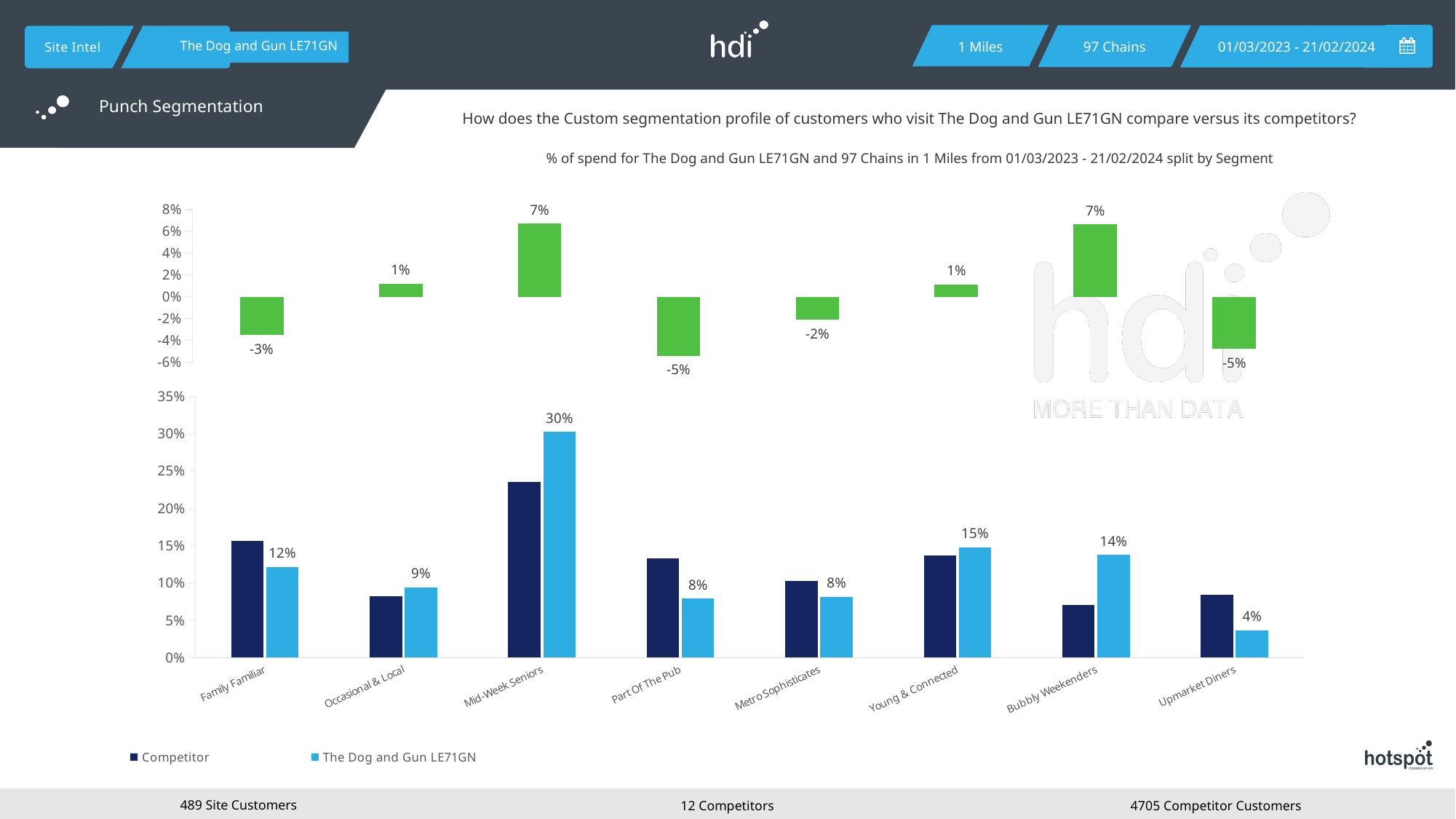
In the bottom chart, which segment has the highest value for The Dog and Gun LE71GN? Mid-Week Seniors In the top chart, what is the value for Metro Sophisticates? -2% In the bottom chart, is the Competitor value for Mid-Week Seniors greater or less than 20%? greater How many segments are shown on the x axis of the bottom chart? 8 In the bottom chart, which segment has the lowest value for The Dog and Gun LE71GN? Upmarket Diners In the bottom chart, what is the value for The Dog and Gun LE71GN in the Mid-Week Seniors segment? 30% In the bottom chart, what is the difference between The Dog and Gun LE71GN values for Young & Connected and Bubbly Weekenders? 1% How many series does the legend of the bottom chart list? 2 In the bottom chart, for Family Familiar, which is larger: the Competitor bar or The Dog and Gun LE71GN bar? Competitor What kind of chart is the bottom chart? bar chart In the top chart, what is the value for Part Of The Pub? -5% In the bottom chart, is the Competitor value for Bubbly Weekenders greater or less than 10%? less